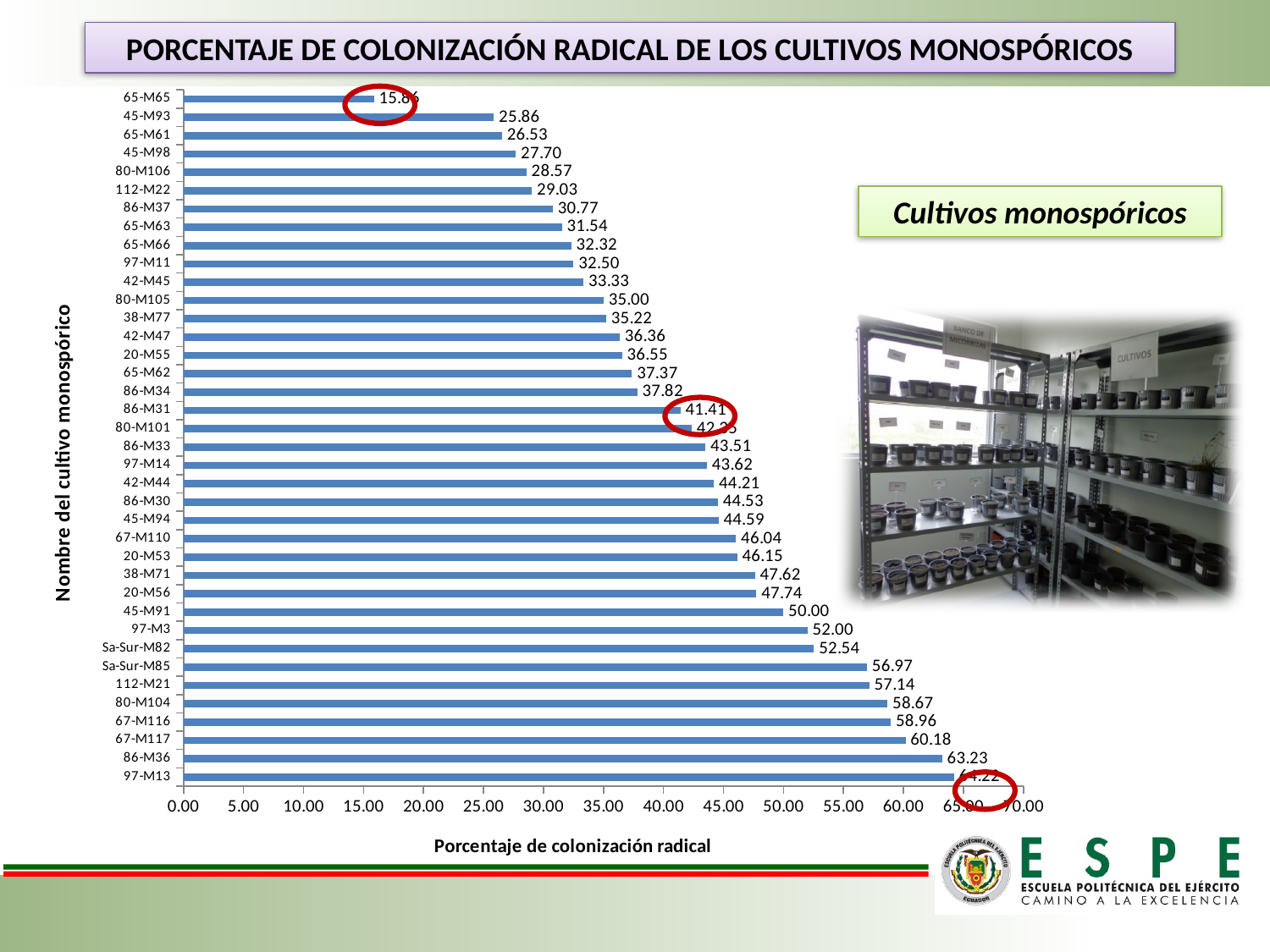
What is the difference between the values for 86-M36 and 45-M93? 37.37 What is the value for 45-M91? 50.00 What is the value for 86-M36? 63.23 Which cultivo monospórico has the highest percentage of root colonization? 97-M13 Which cultivo monospórico has the lowest percentage of root colonization? 65-M65 Is the value for 65-M65 greater or less than 20.00? less What is the value for 45-M93? 25.86 What type of chart is shown on the slide? Bar chart What is the title of the horizontal axis of the chart? Porcentaje de colonización radical What is the value for 86-M31? 41.41 Which has a larger value, 67-M117 or 45-M91? 67-M117 How many cultivos monospóricos are plotted in the chart? 38